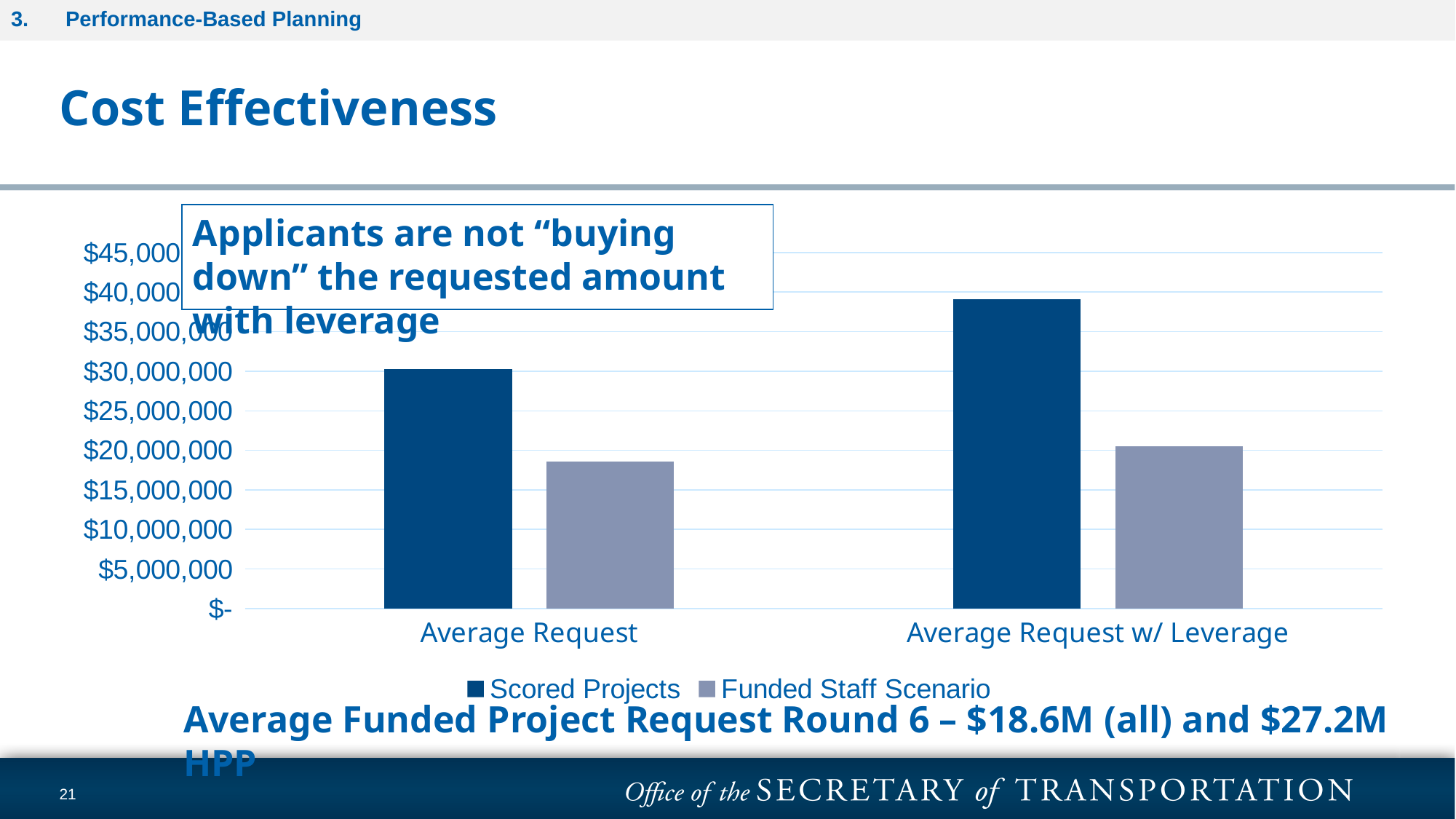
Does the Scored Projects series rise or fall from Average Request to Average Request w/ Leverage? rise Is the Scored Projects value for Average Request w/ Leverage greater or less than $35,000,000? greater How many categories are shown on the x axis of the chart? 2 What kind of chart is shown on the slide? bar chart How many series does the chart legend list? 2 For the Average Request category, which series has the larger value: Scored Projects or Funded Staff Scenario? Scored Projects Which series and category has the shortest bar in the chart? Funded Staff Scenario, Average Request Is the Funded Staff Scenario value for Average Request greater or less than $20,000,000? less Is the Funded Staff Scenario value for Average Request w/ Leverage greater or less than $25,000,000? less Which series and category has the tallest bar in the chart? Scored Projects, Average Request w/ Leverage What are the two entries in the chart legend? Scored Projects and Funded Staff Scenario